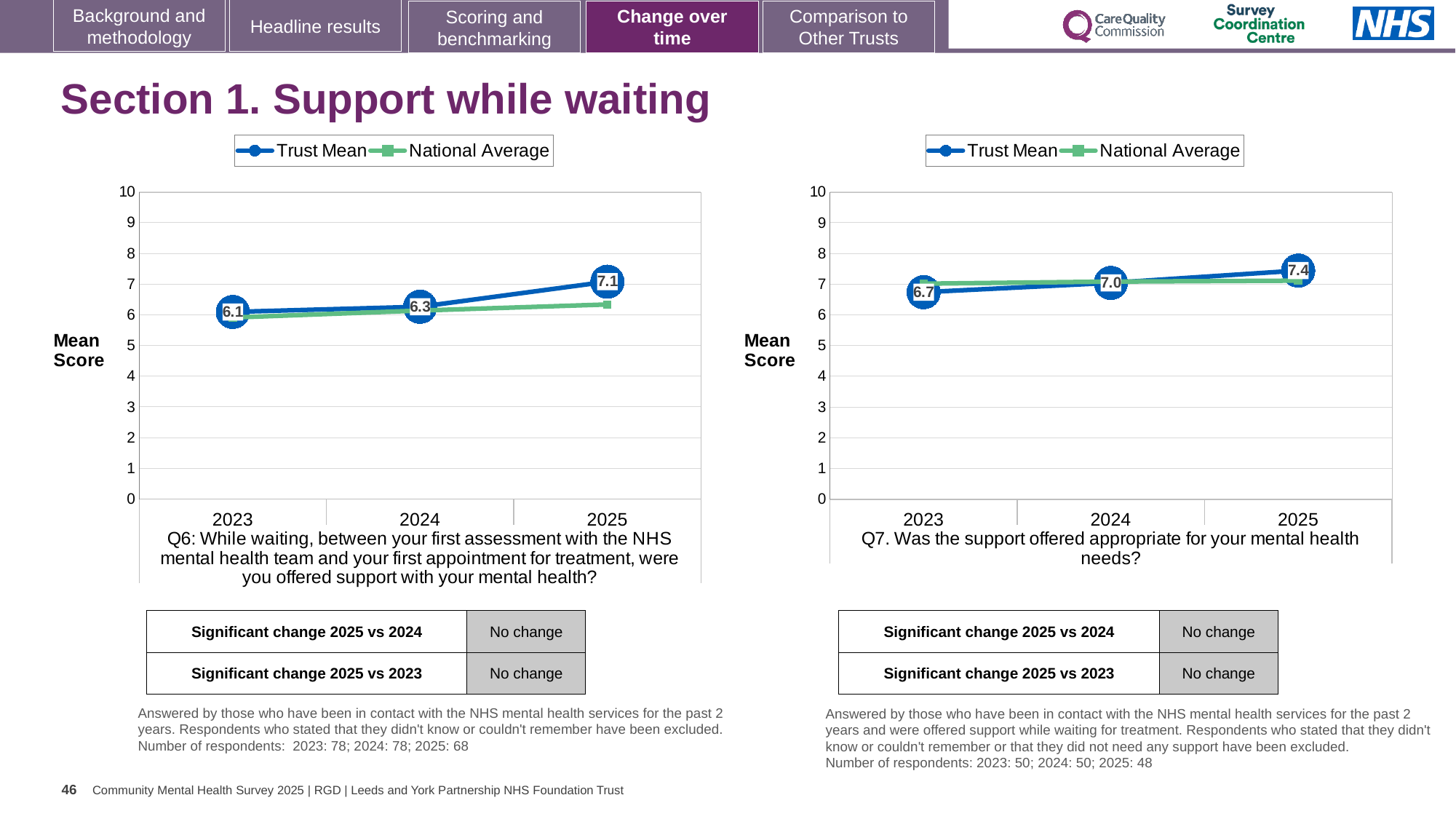
What type of chart is the Q6 chart (left)? line chart On the Q7 chart (right), what is the difference between the Trust Mean in 2025 and in 2024? 0.4 On the Q6 chart (left), in which year is the Trust Mean highest? 2025 On the Q6 chart (left), does the Trust Mean rise or fall from 2023 to 2025? rise On the Q7 chart (right), what is the Trust Mean score for 2024? 7.0 On the Q6 chart (left), what is the difference between the Trust Mean in 2025 and in 2023? 1.0 On the Q6 chart (left), what is the Trust Mean score for 2025? 7.1 On the Q6 chart (left), what is the Trust Mean score for 2023? 6.1 On the Q7 chart (right), what is the Trust Mean score for 2025? 7.4 On the Q7 chart (right), in which year is the Trust Mean lowest? 2023 On the Q6 chart (left), is the Trust Mean for 2025 greater or less than 7? greater How many series does the legend of the Q7 chart (right) list? 2